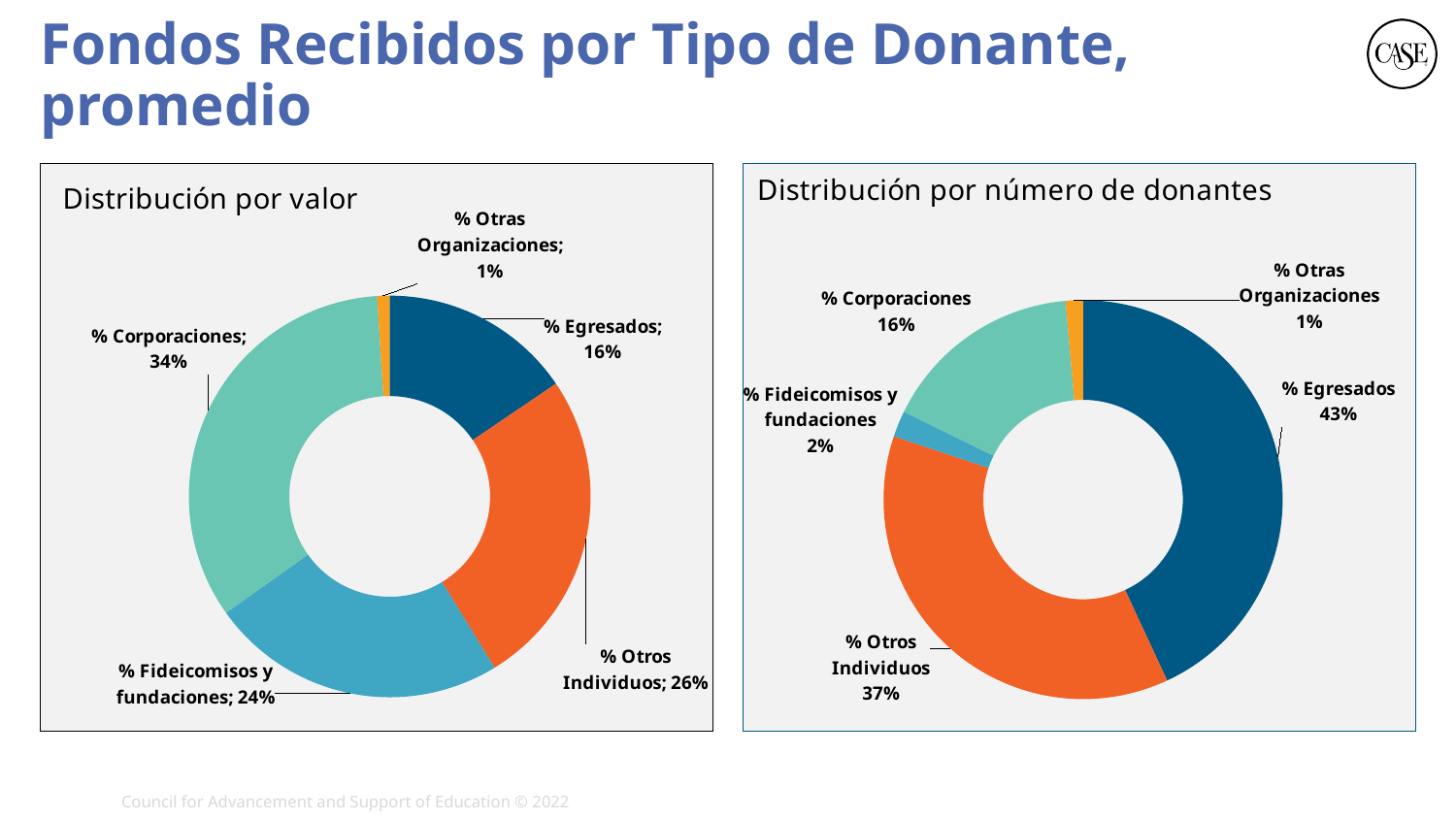
In the 'Distribución por número de donantes' chart, what share is labelled for % Egresados? 43% In the 'Distribución por valor' chart, what share is labelled for % Corporaciones? 34% In the 'Distribución por valor' chart, what is the difference between the shares for % Otros Individuos and % Egresados? 10% In the 'Distribución por número de donantes' chart, which is larger, % Corporaciones or % Otros Individuos? % Otros Individuos What kind of chart is the 'Distribución por número de donantes' chart? Doughnut (pie) chart How many categories are shown in the 'Distribución por valor' chart? 5 In the 'Distribución por número de donantes' chart, what share is labelled for % Fideicomisos y fundaciones? 2% In the 'Distribución por número de donantes' chart, which category has the largest share? % Egresados In the 'Distribución por valor' chart, which category has the largest share? % Corporaciones In the 'Distribución por valor' chart, which category has the smallest share? % Otras Organizaciones In the 'Distribución por número de donantes' chart, what is the difference between the shares for % Egresados and % Otros Individuos? 6% In the 'Distribución por valor' chart, what share is labelled for % Fideicomisos y fundaciones? 24%